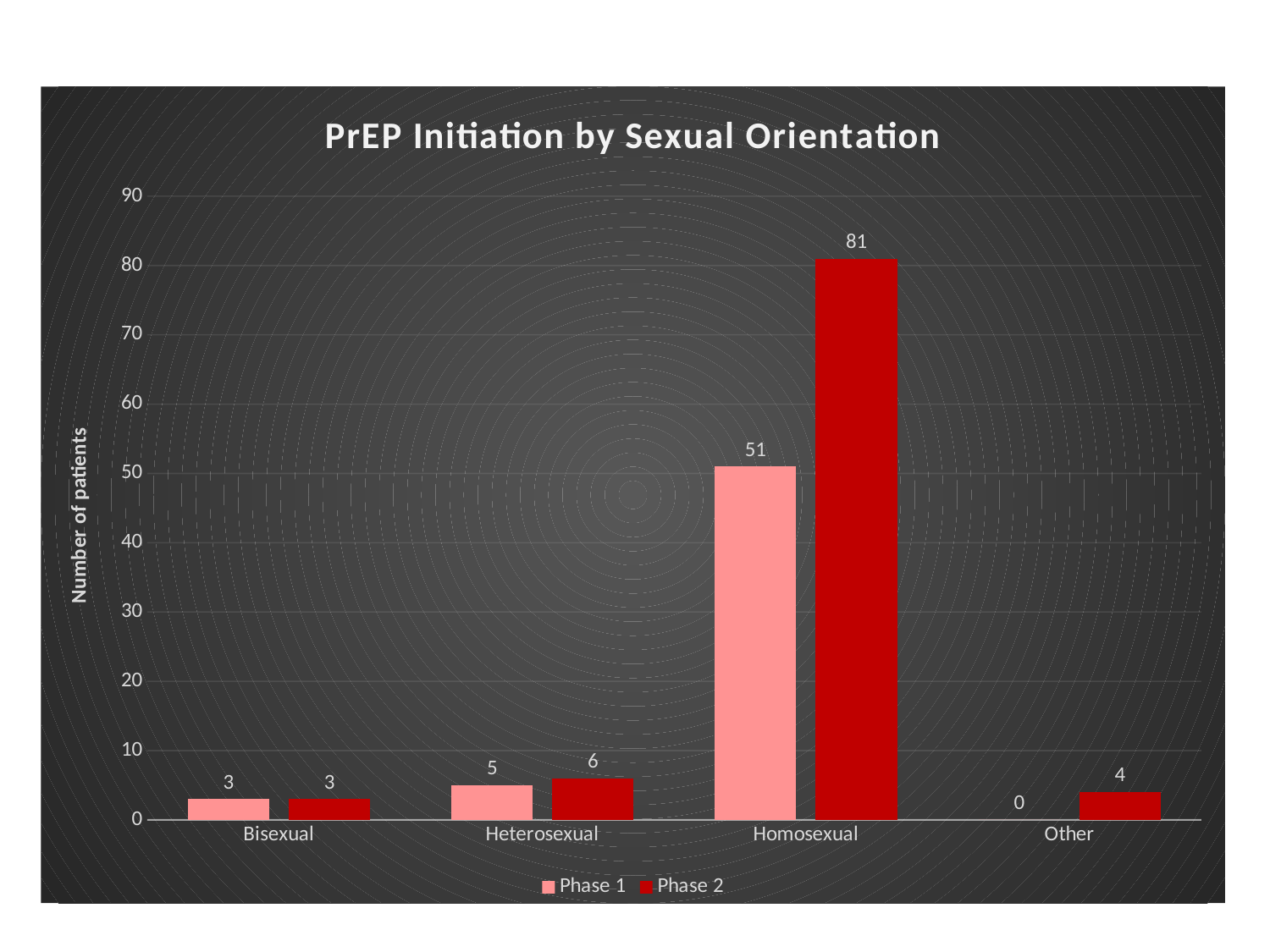
What is the title of the chart? PrEP Initiation by Sexual Orientation Which category has the highest Phase 1 value? Homosexual What is the Phase 1 value for Other? 0 How many categories are shown on the x axis? 4 What kind of chart is shown? bar chart How many series does the legend list? 2 What is the difference between the Phase 2 and Phase 1 values for Homosexual? 30 What is the Phase 1 value for Heterosexual? 5 Is the Phase 1 value for Homosexual greater or less than 40? greater Which category has the lowest Phase 2 value? Bisexual Which is larger for Heterosexual, the Phase 1 value or the Phase 2 value? Phase 2 What is the Phase 2 value for Homosexual? 81